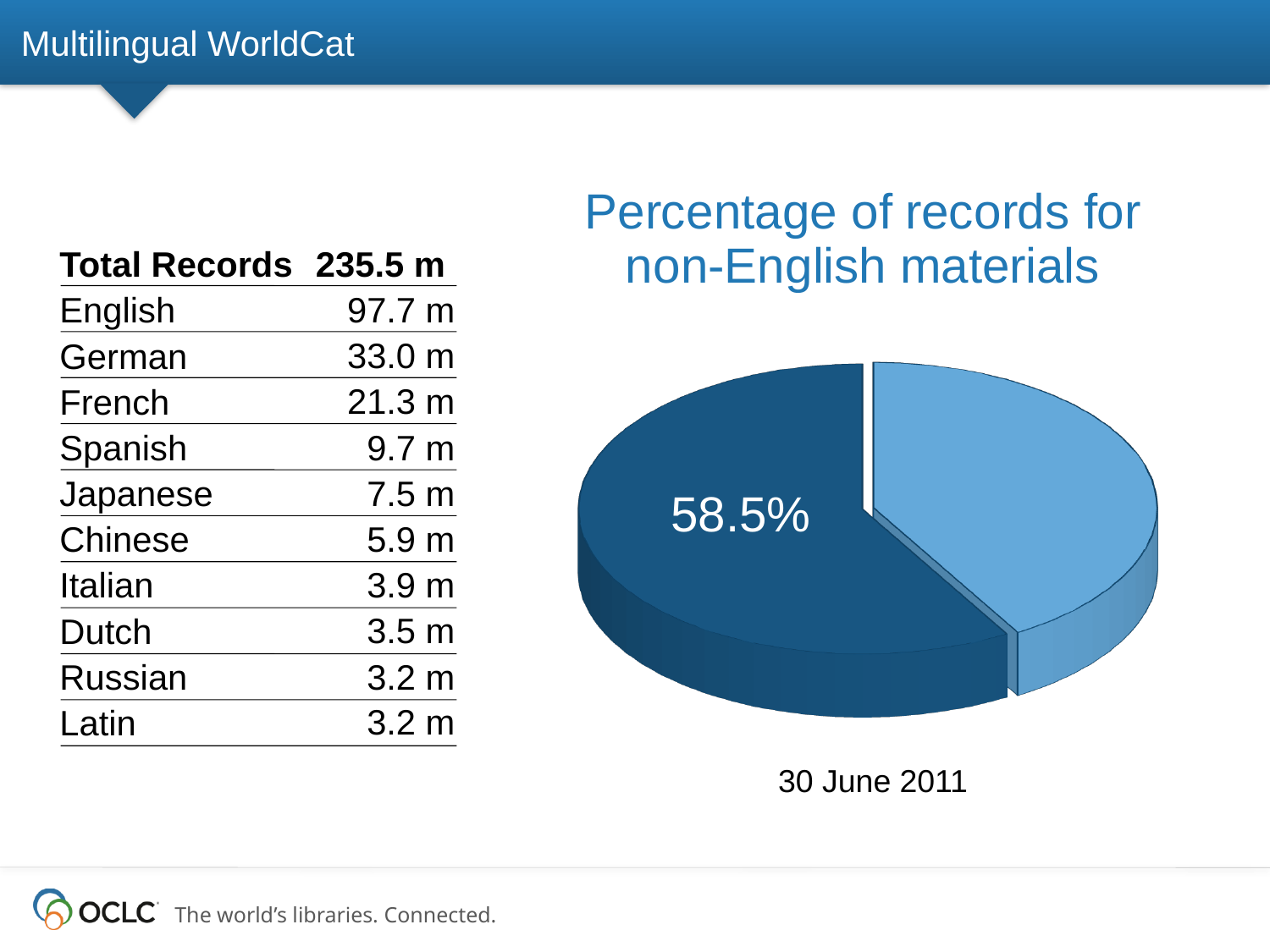
What kind of chart is shown on the slide? pie chart Which slice of the pie chart is larger, the dark blue one or the light blue one? the dark blue one How many slices does the pie chart have? 2 What is the title of the pie chart? Percentage of records for non-English materials What percentage is printed on the dark blue slice of the pie chart? 58.5% Is the share shown on the labelled slice of the pie chart greater or less than 50%? greater What date is shown beneath the pie chart? 30 June 2011